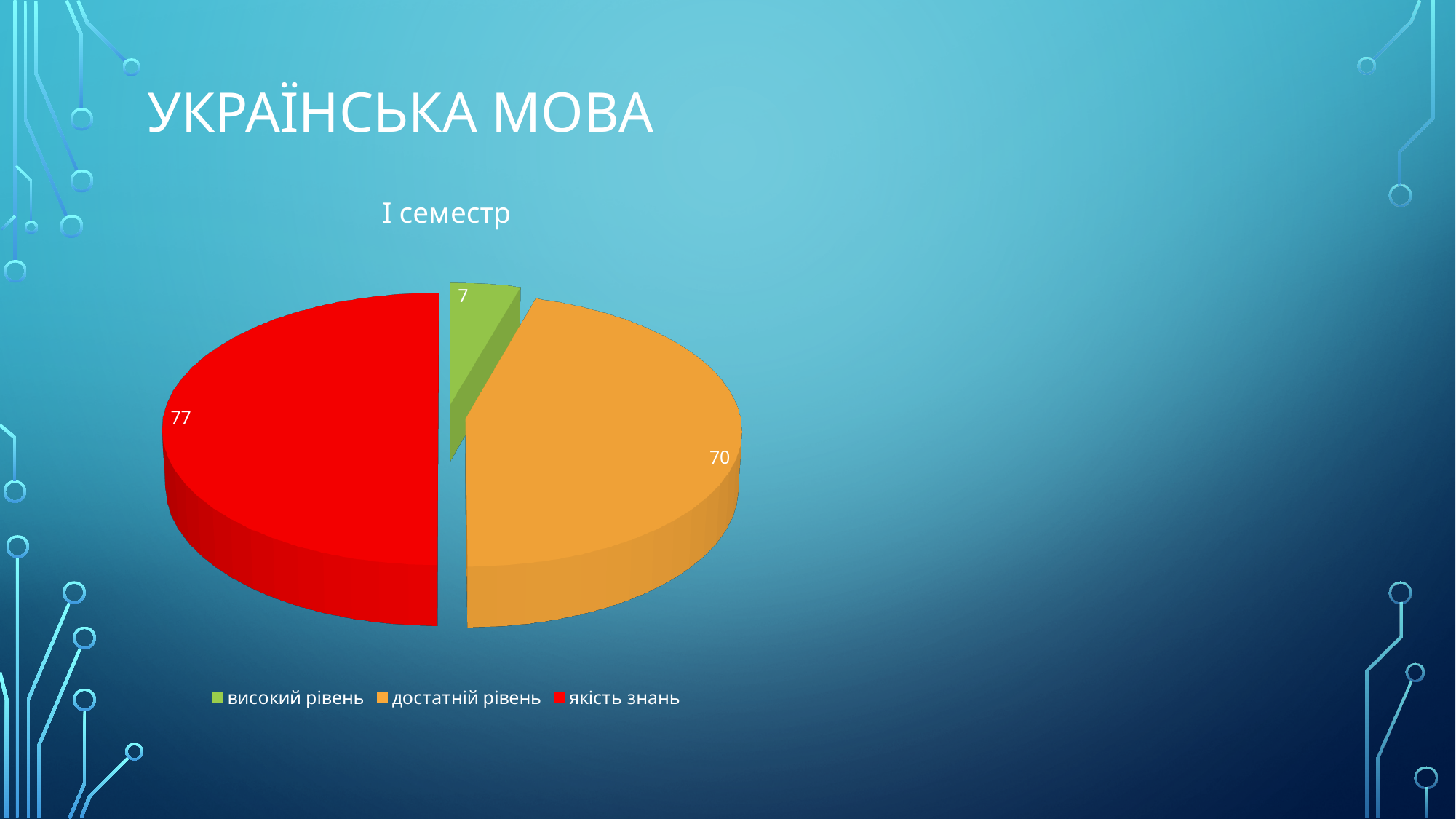
Which category has the largest slice? якість знань What is the value for якість знань? 77 What is the value for достатній рівень? 70 Which category has the smallest slice? високий рівень What kind of chart is shown on the slide? pie chart What colour is the slice for якість знань? red What is the title of the chart? І семестр Which is larger, the value for достатній рівень or the value for високий рівень? достатній рівень What is the difference between the values for достатній рівень and високий рівень? 63 What is the difference between the values for якість знань and достатній рівень? 7 How many slices does the pie chart have? 3 What is the value for високий рівень? 7